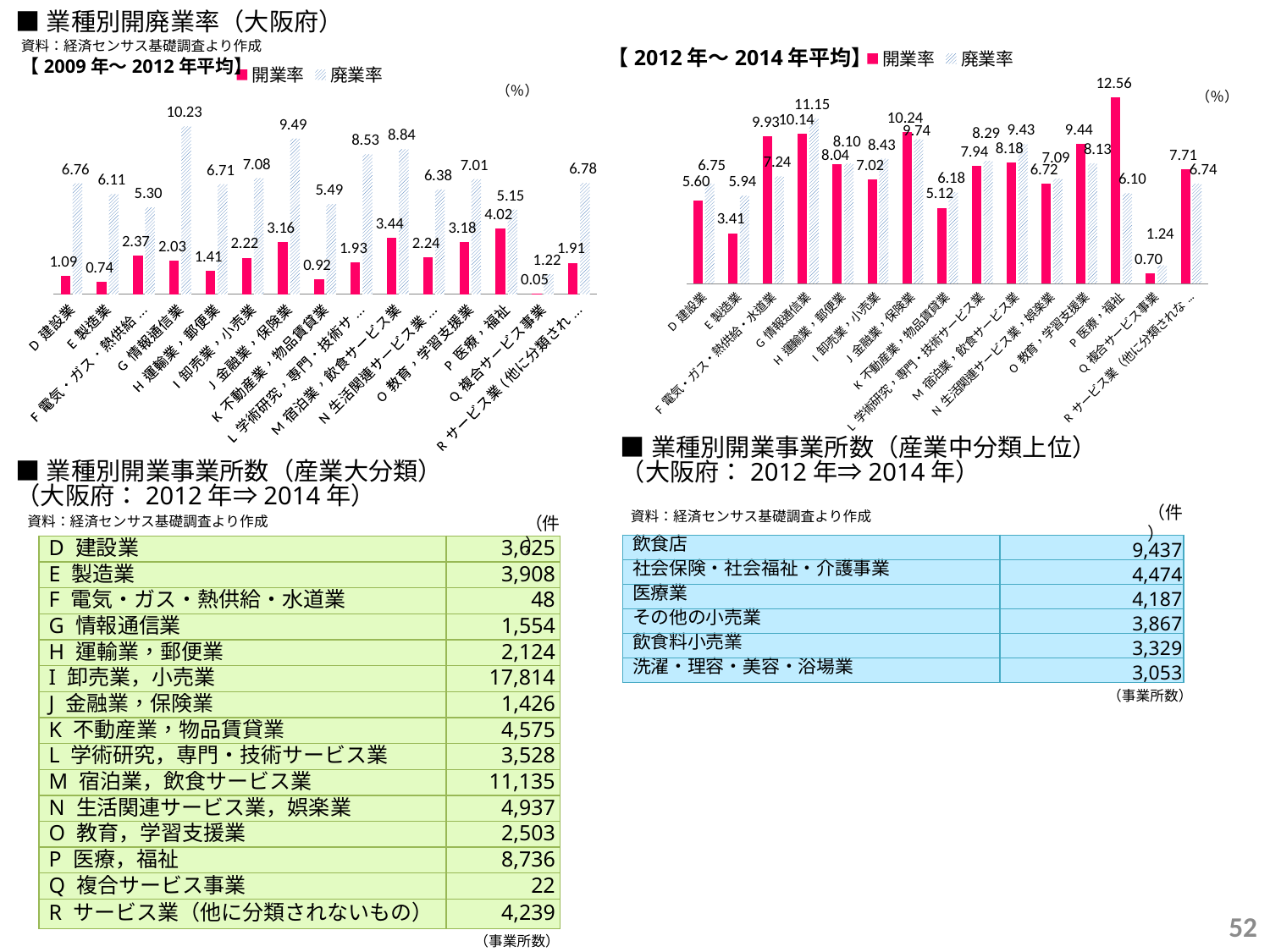
In the 【2012年～2014年平均】 chart, what is the 開業率 for P 医療，福祉? 12.56 In the 【2009年～2012年平均】 chart, what is the 開業率 for D 建設業? 1.09 What type of chart is the 【2009年～2012年平均】 chart? Bar chart In the 【2012年～2014年平均】 chart, what is the 廃業率 for G 情報通信業? 11.15 In the 【2009年～2012年平均】 chart, what is the difference between the 廃業率 and 開業率 for J 金融業，保険業? 6.33 How many series does the legend of the 【2012年～2014年平均】 chart list? 2 In the 【2012年～2014年平均】 chart, what is the difference between the 開業率 and 廃業率 for P 医療，福祉? 6.46 In the 【2009年～2012年平均】 chart, which category has the highest 開業率? P 医療，福祉 In the 【2012年～2014年平均】 chart, which is larger for I 卸売業，小売業: the 開業率 or the 廃業率? 廃業率 In the 【2012年～2014年平均】 chart, which category has the lowest 開業率? Q 複合サービス事業 In the 【2009年～2012年平均】 chart, what is the 廃業率 for G 情報通信業? 10.23 In the 【2009年～2012年平均】 chart, which category has the lowest 廃業率? Q 複合サービス事業